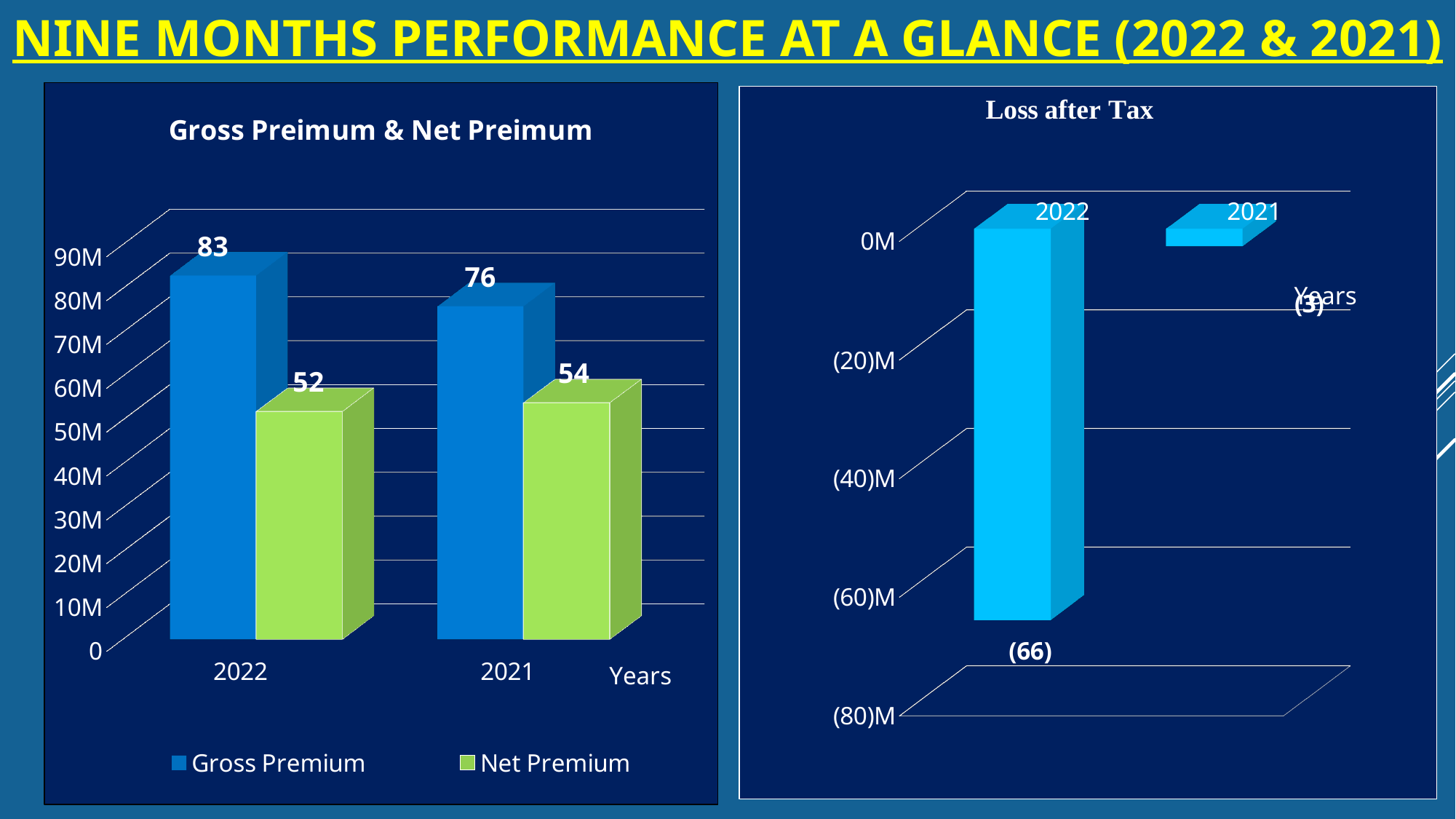
In the 'Gross Preimum & Net Preimum' chart, what is the Net Premium value for 2022? 52 What type of chart is the 'Loss after Tax' chart? bar chart In the 'Loss after Tax' chart, what is the value for 2021? (3) In the 'Gross Preimum & Net Preimum' chart, what colour are the Net Premium bars? green In the 'Loss after Tax' chart, what is the value for 2022? (66) In the 'Gross Preimum & Net Preimum' chart, what is the difference between the Gross Premium values for 2022 and 2021? 7 In the 'Gross Preimum & Net Preimum' chart, is the Net Premium for 2021 larger or smaller than the Net Premium for 2022? larger In the 'Gross Preimum & Net Preimum' chart, what is the Gross Premium value for 2022? 83 In the 'Gross Preimum & Net Preimum' chart, which year has the higher Gross Premium? 2022 In the 'Gross Preimum & Net Preimum' chart, what is the Net Premium value for 2021? 54 In the 'Loss after Tax' chart, how many years are plotted? 2 In the 'Gross Preimum & Net Preimum' chart, how many series does the legend list? 2